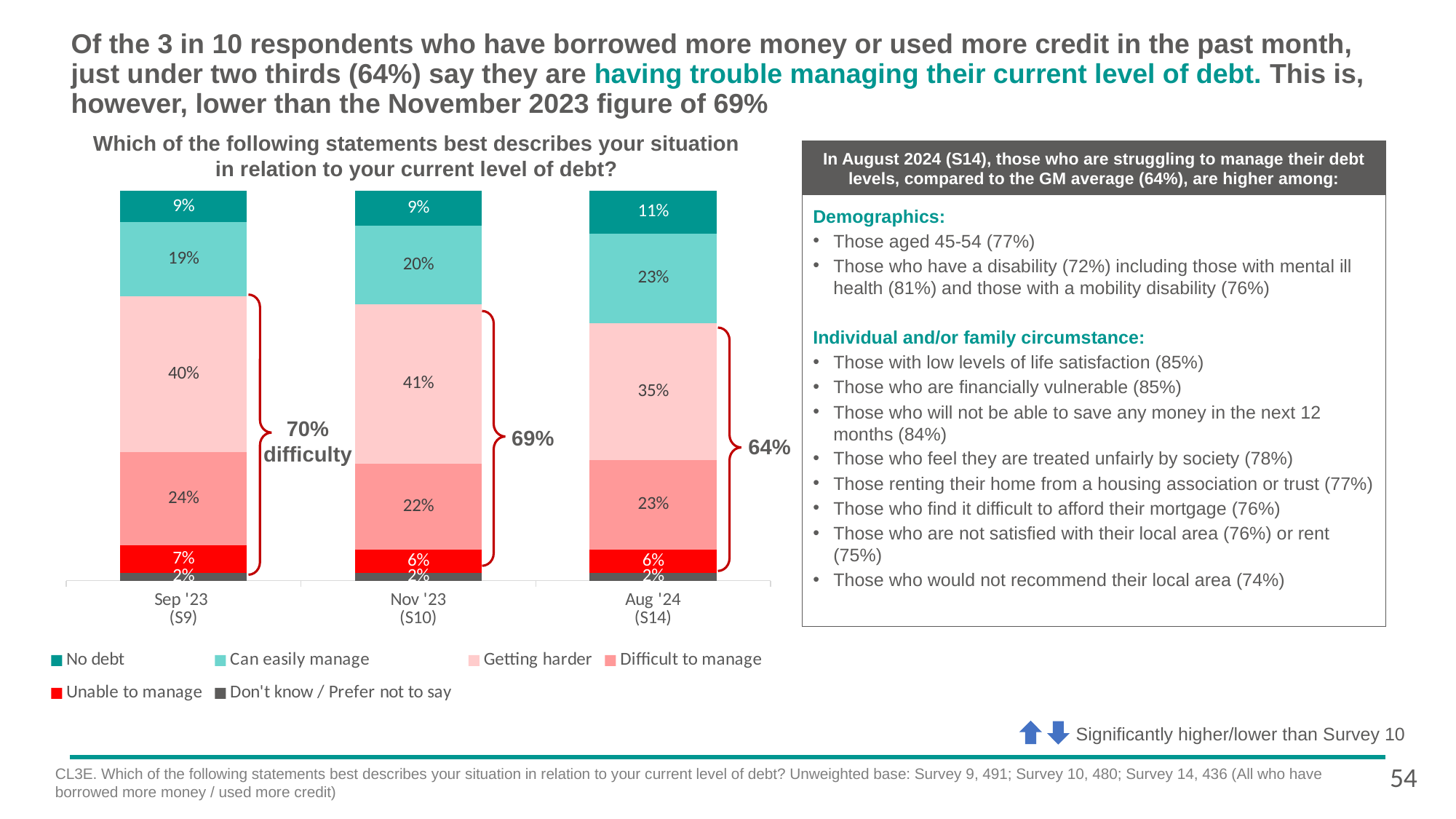
In which survey wave is the 'Getting harder' share highest? Nov '23 (S10) How many survey waves (bars) are shown on the chart? 3 How does the bracketed 'difficulty' total change across the three survey waves from Sep '23 to Aug '24? It falls (70% to 69% to 64%) What is the combined 'difficulty' percentage shown by the bracket for Aug '24 (S14)? 64% What percentage of respondents in Sep '23 (S9) said they have 'No debt'? 9% Which is larger: the 'Difficult to manage' share in Sep '23 (S9) or in Nov '23 (S10)? Sep '23 (S9) What is the difference between the 'Getting harder' values for Nov '23 (S10) and Aug '24 (S14)? 6 percentage points What type of chart is shown on the slide? Stacked bar chart In which survey wave is the 'Can easily manage' share lowest? Sep '23 (S9) What is the 'Can easily manage' value for Nov '23 (S10)? 20% How many series does the chart legend list? 6 What percentage of respondents in Aug '24 (S14) said their debt is 'Getting harder' to manage? 35%